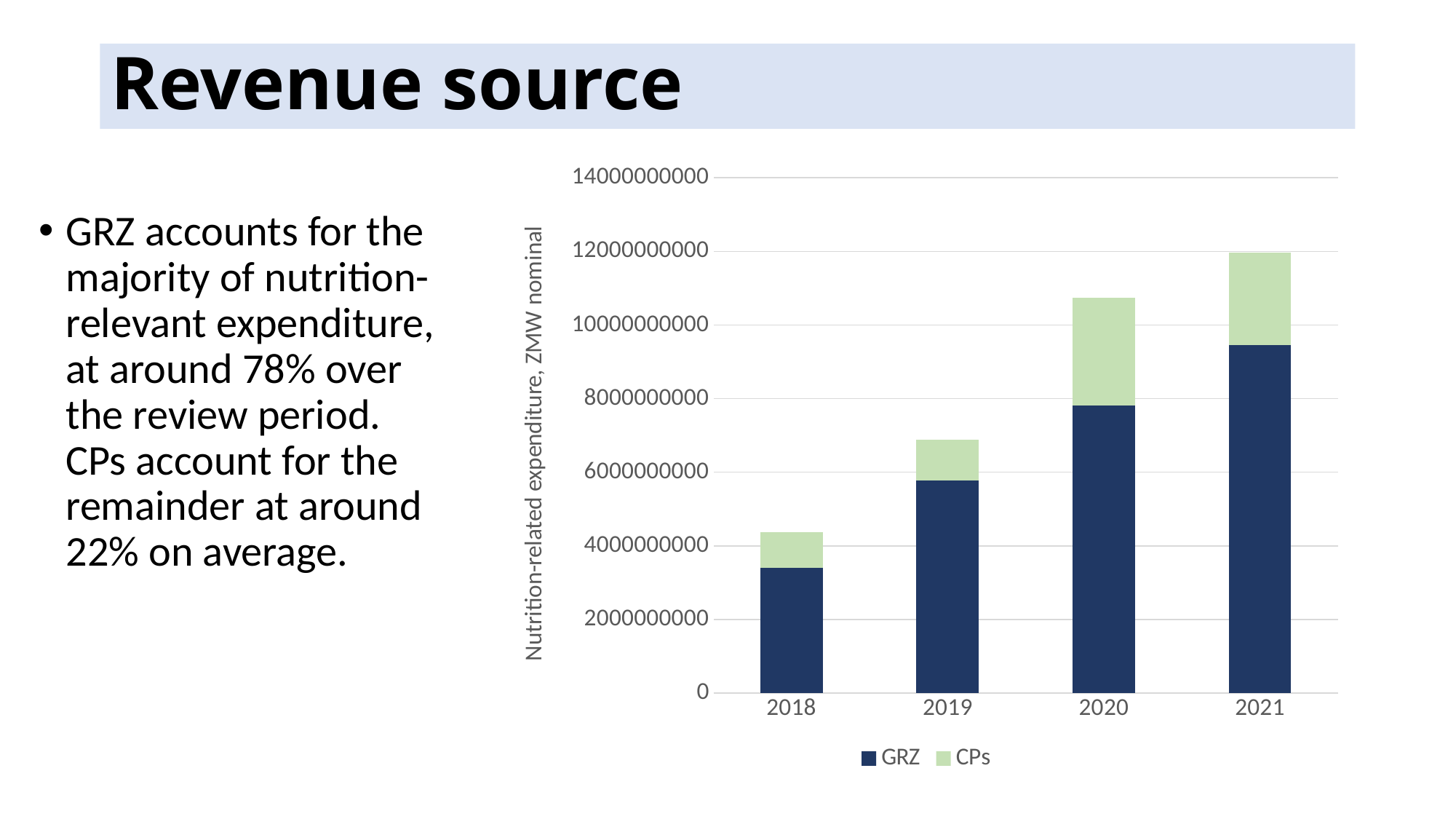
What kind of chart is shown on the slide? Stacked bar chart Do the total bar heights rise or fall from 2018 to 2021? Rise Which year has the lowest total nutrition-related expenditure? 2018 Which year has the highest total nutrition-related expenditure? 2021 Is the GRZ value for 2018 greater or less than 4000000000? less How many years are shown on the x axis of the chart? 4 Which series is larger in 2021, GRZ or CPs? GRZ Is the total bar for 2019 greater or less than 6000000000? greater How many series does the chart legend list? 2 Is the GRZ value for 2020 greater or less than 8000000000? less What is the label on the vertical axis of the chart? Nutrition-related expenditure, ZMW nominal